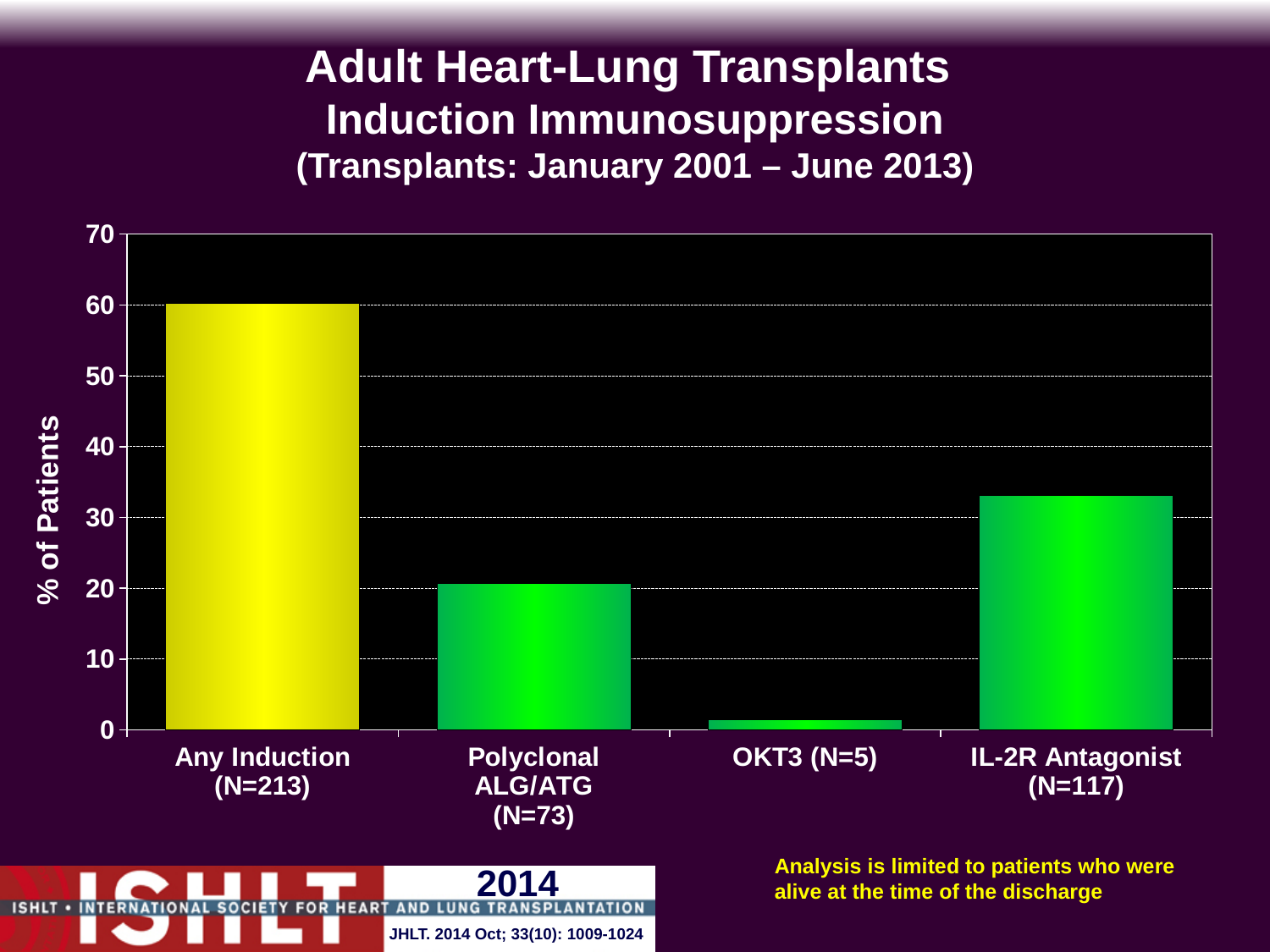
What kind of chart is shown on the slide? bar chart Is the value for IL-2R Antagonist (N=117) greater or less than 30? greater What is the label of the y axis of the chart? % of Patients Which is larger, the value for Polyclonal ALG/ATG (N=73) or the value for IL-2R Antagonist (N=117)? IL-2R Antagonist (N=117) How many categories are shown on the x axis of the chart? 4 Is the value for IL-2R Antagonist (N=117) greater or less than 40? less Which category has the highest % of patients? Any Induction (N=213) Is the value for Polyclonal ALG/ATG (N=73) greater or less than 30? less What is the maximum value shown on the y axis of the chart? 70 Which category has the lowest % of patients? OKT3 (N=5)